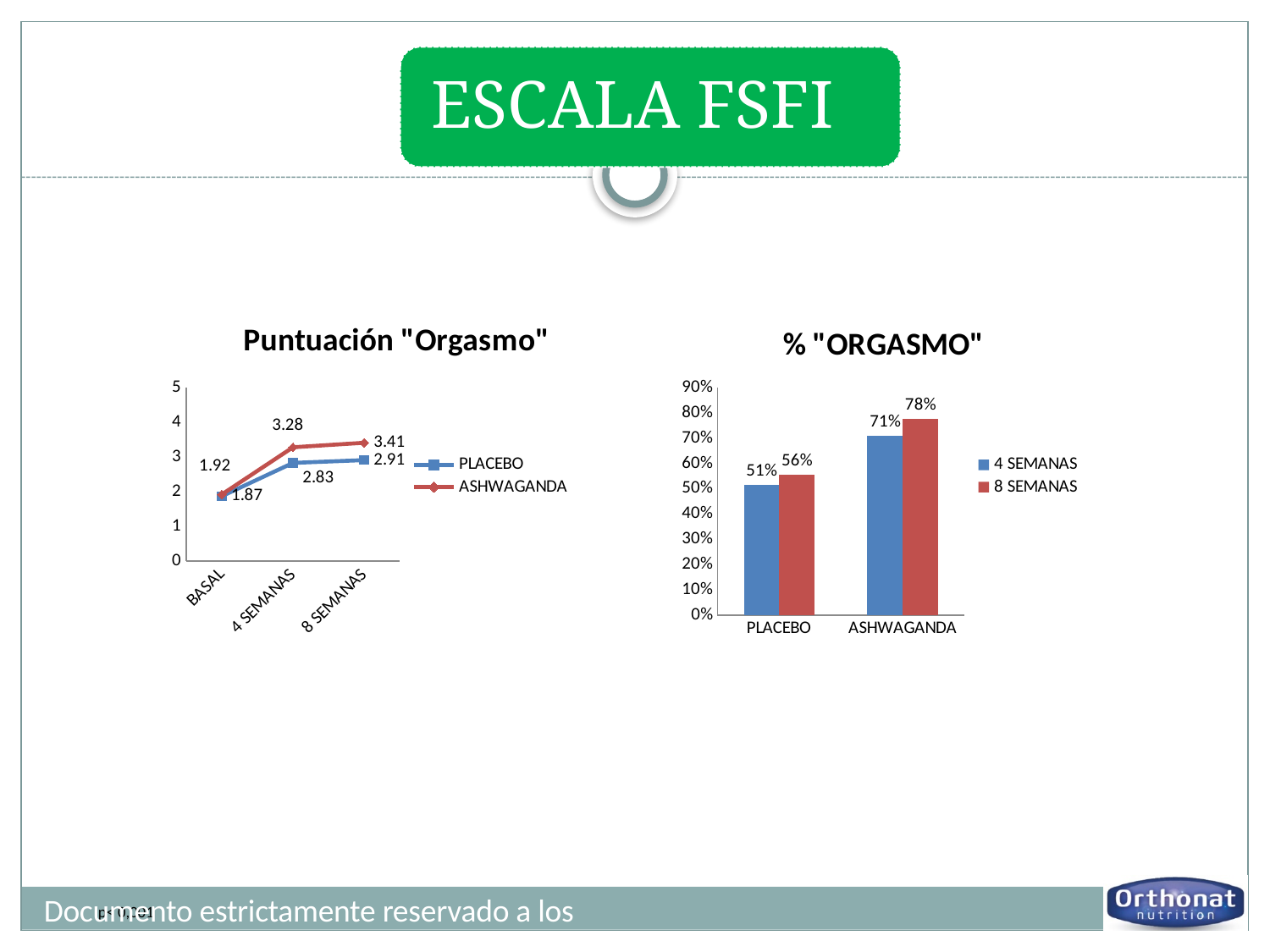
In the "Puntuación "Orgasmo"" chart, what is the value for PLACEBO at 4 SEMANAS? 2.83 What kind of chart is the "% "ORGASMO"" chart? bar chart In the "% "ORGASMO"" chart, what is the difference between ASHWAGANDA and PLACEBO at 4 SEMANAS? 20% In the "Puntuación "Orgasmo"" chart, what is the value for ASHWAGANDA at 8 SEMANAS? 3.41 What kind of chart is the "Puntuación "Orgasmo"" chart? line chart In the "Puntuación "Orgasmo"" chart, what is the difference between ASHWAGANDA and PLACEBO at 8 SEMANAS? 0.5 In the "% "ORGASMO"" chart, which is larger: PLACEBO at 8 SEMANAS or ASHWAGANDA at 4 SEMANAS? ASHWAGANDA at 4 SEMANAS In the "% "ORGASMO"" chart, what is the value for PLACEBO at 4 SEMANAS? 51% In the "% "ORGASMO"" chart, what is the value for ASHWAGANDA at 8 SEMANAS? 78% In the "% "ORGASMO"" chart, which bar is the highest? ASHWAGANDA, 8 SEMANAS In the "Puntuación "Orgasmo"" chart, how many series does the legend list? 2 In the "Puntuación "Orgasmo"" chart, does the PLACEBO series rise or fall from BASAL to 8 SEMANAS? rise